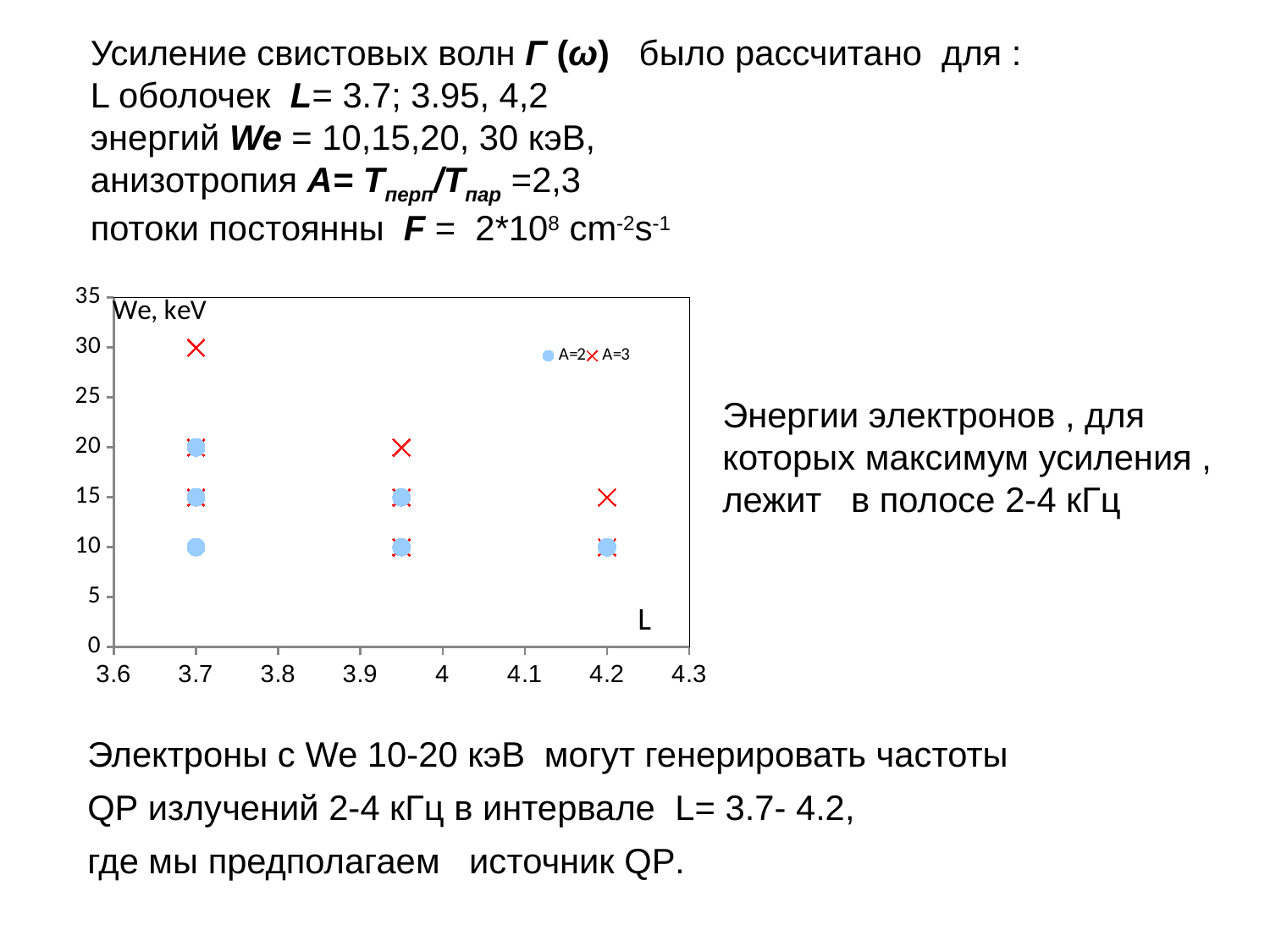
What are the two series named in the chart legend? A=2 and A=3 How many A=2 points are plotted at L = 3.7? 3 What is the label on the vertical axis of the chart? We, keV What is the highest We value plotted for the A=2 series? 20 What is the difference between the highest We value of the A=3 series and the highest We value of the A=2 series? 10 What is the highest We value plotted for the A=3 series? 30 What kind of chart is shown on the slide? scatter chart How many series does the chart legend list? 2 Which series has the higher maximum We value, A=2 or A=3? A=3 How many A=2 points are plotted at L = 4.2? 1 What is the lowest We value plotted on the chart? 10 At which L value does the A=3 series reach its highest We value? 3.7